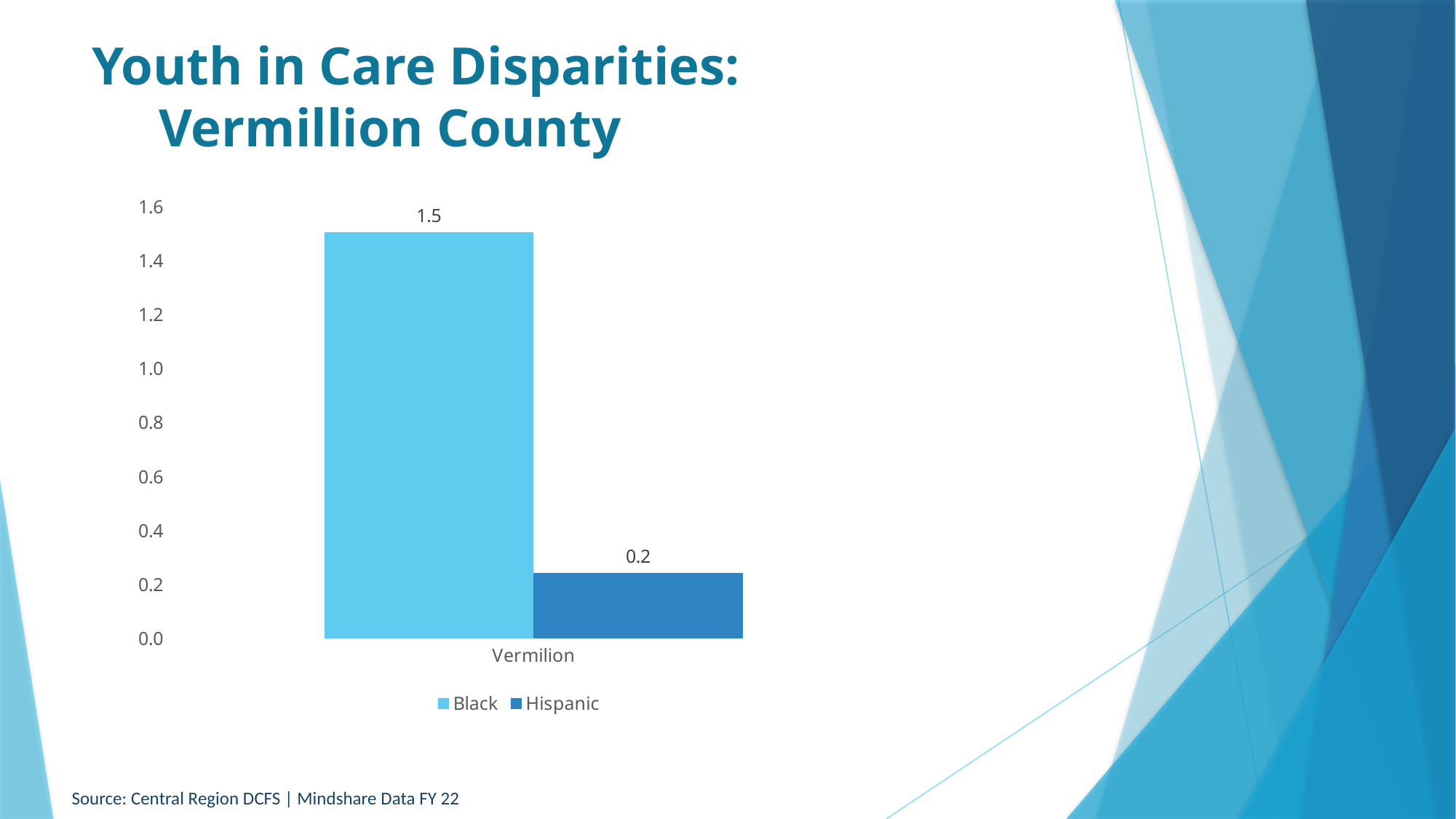
What is the value for Hispanic in Vermilion? 0.2 How many categories are shown on the x axis? 1 What is the value for Black in Vermilion? 1.5 Which series has the higher value for Vermilion, Black or Hispanic? Black Is the value for Black in Vermilion greater or less than 1.0? greater What is the category label on the x axis? Vermilion Is the value for Hispanic in Vermilion greater or less than 0.4? less How many series does the legend list? 2 Which series has the lowest value in the chart? Hispanic What kind of chart is shown on the slide? Bar chart What is the difference between the Black and Hispanic values for Vermilion? 1.3 What is the highest value shown on the y axis? 1.6